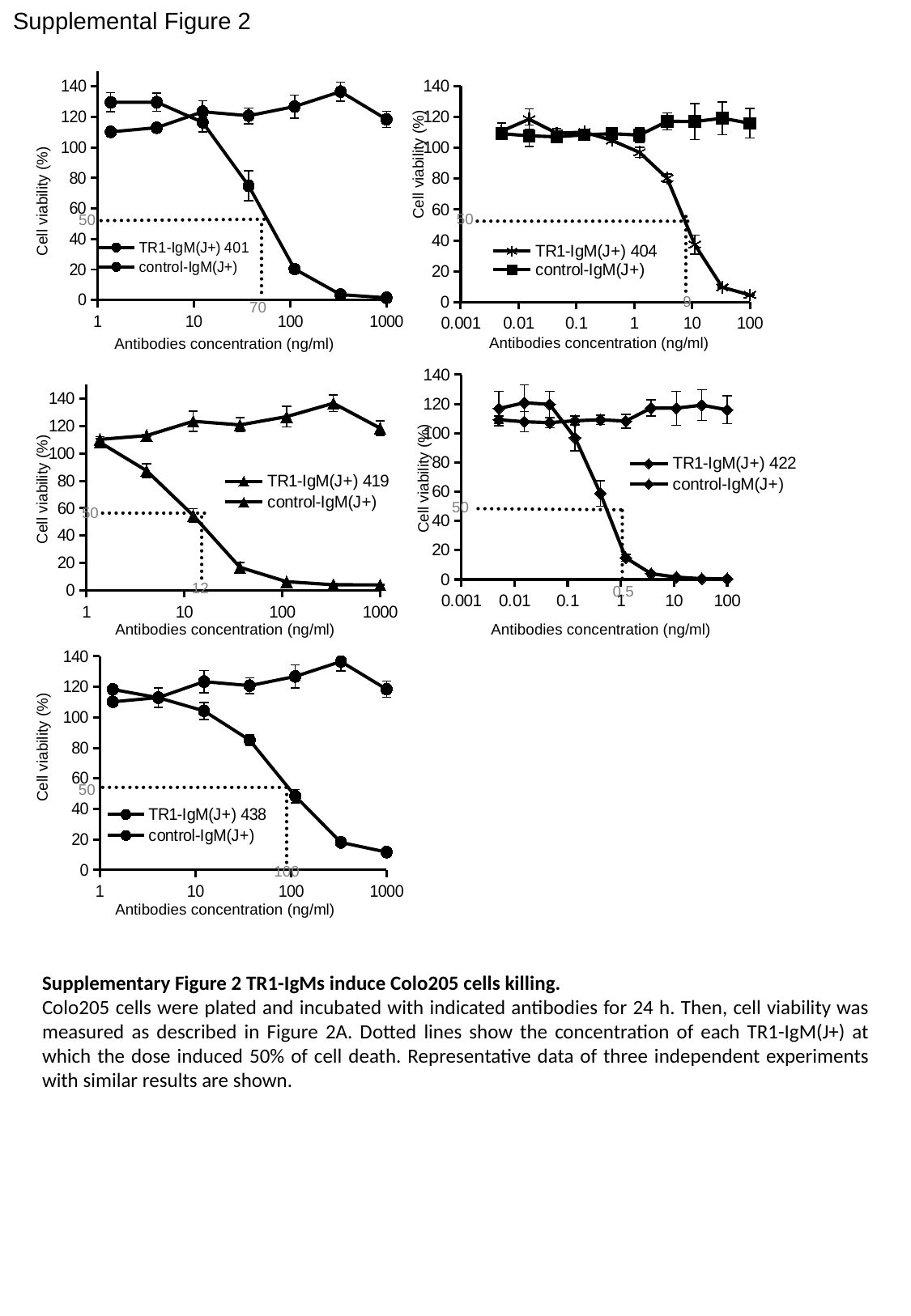
In the top-left chart, is the value for TR1-IgM(J+) 401 at 1000 ng/ml greater or less than 20? less In the top-left chart, is the value for control-IgM(J+) at 1000 ng/ml greater or less than 100? greater What is the y-axis label of the middle-right chart (TR1-IgM(J+) 422)? Cell viability (%) In the middle-left chart (TR1-IgM(J+) 419), which series has the larger value at 1000 ng/ml, TR1-IgM(J+) 419 or control-IgM(J+)? control-IgM(J+) How many series does the legend of the top-right chart (TR1-IgM(J+) 404) list? 2 In the top-right chart, which series has the larger value at 100 ng/ml, TR1-IgM(J+) 404 or control-IgM(J+)? control-IgM(J+) What kind of chart is the top-left chart (TR1-IgM(J+) 401)? line chart In the middle-right chart, is the value for TR1-IgM(J+) 422 at 100 ng/ml greater or less than 20? less In the top-left chart, does the TR1-IgM(J+) 401 series rise or fall as antibody concentration increases? fall How many charts are shown on the slide? 5 What is the x-axis label of the bottom-left chart (TR1-IgM(J+) 438)? Antibodies concentration (ng/ml)